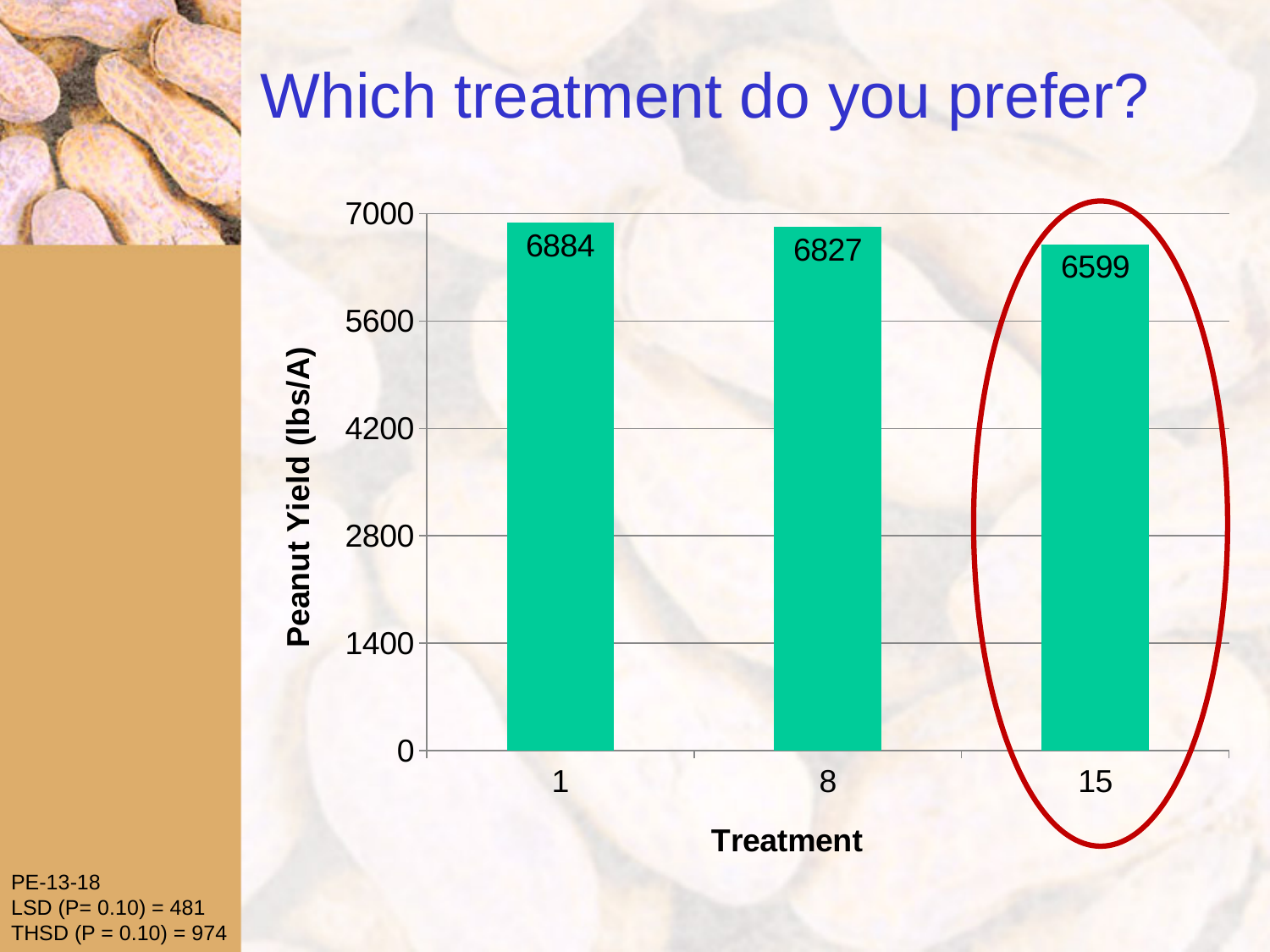
What is the peanut yield for treatment 15? 6599 Which treatment has the lowest peanut yield? 15 Which has a higher peanut yield, treatment 8 or treatment 15? Treatment 8 Is the peanut yield for treatment 15 greater or less than 5600? greater What is the label of the y axis? Peanut Yield (lbs/A) Which treatment has the highest peanut yield? 1 What is the difference in peanut yield between treatment 8 and treatment 15? 228 What is the difference in peanut yield between treatment 1 and treatment 15? 285 What is the peanut yield for treatment 1? 6884 How many treatments are shown on the chart? 3 What is the peanut yield for treatment 8? 6827 What kind of chart is shown on the slide? Bar chart